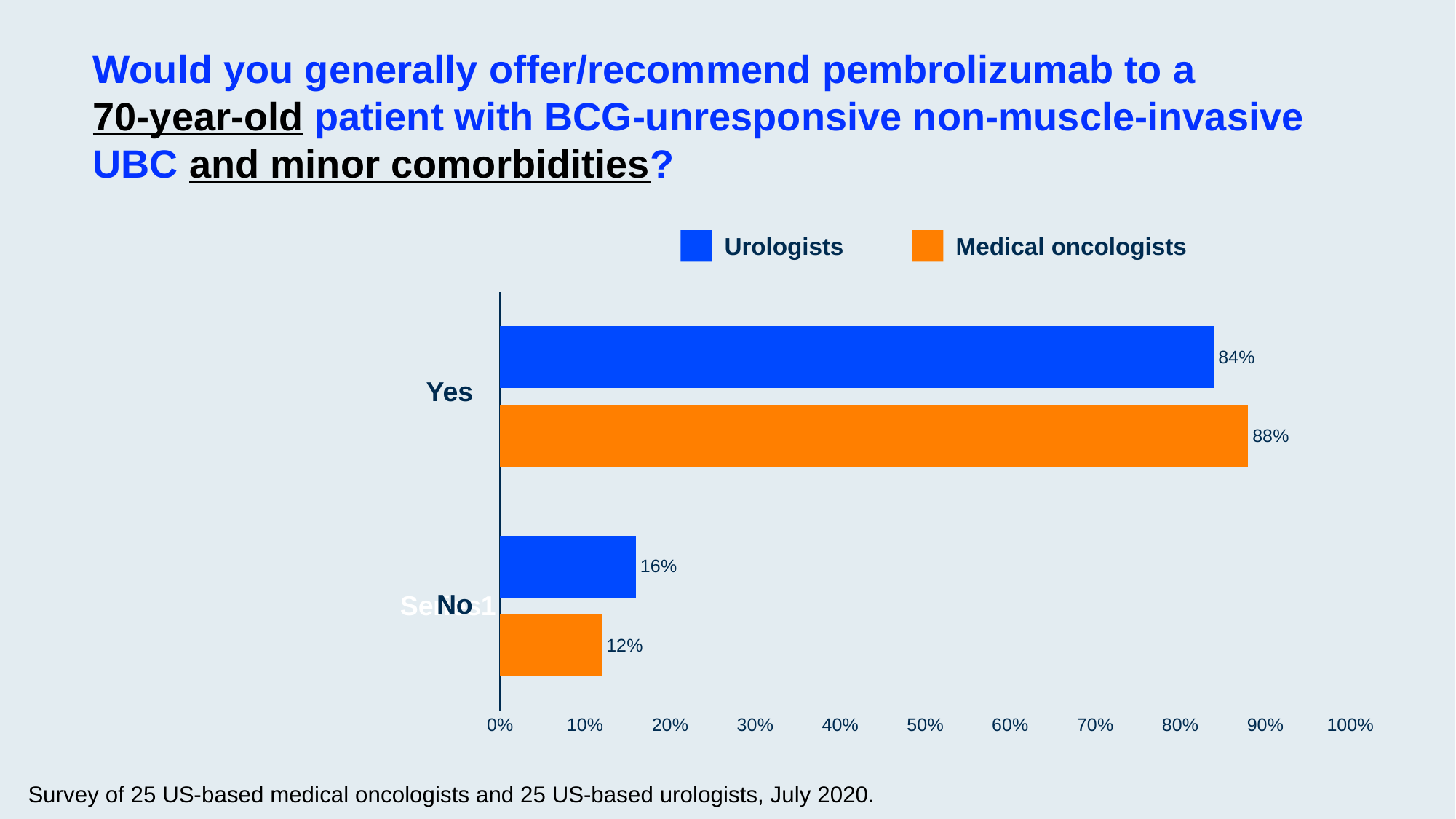
What percentage of urologists answered Yes? 84% What is the difference between the medical oncologists' and urologists' Yes percentages? 4% Which group has the higher percentage answering Yes, urologists or medical oncologists? Medical oncologists How many response categories are shown on the chart? 2 How many series does the legend list? 2 Which colour represents medical oncologists in the chart? Orange What is the difference between the urologists' and medical oncologists' No percentages? 4% What kind of chart is shown on the slide? Bar chart What percentage of medical oncologists answered Yes? 88% What percentage of urologists answered No? 16% What percentage of medical oncologists answered No? 12% Which response category has the lowest value for medical oncologists? No